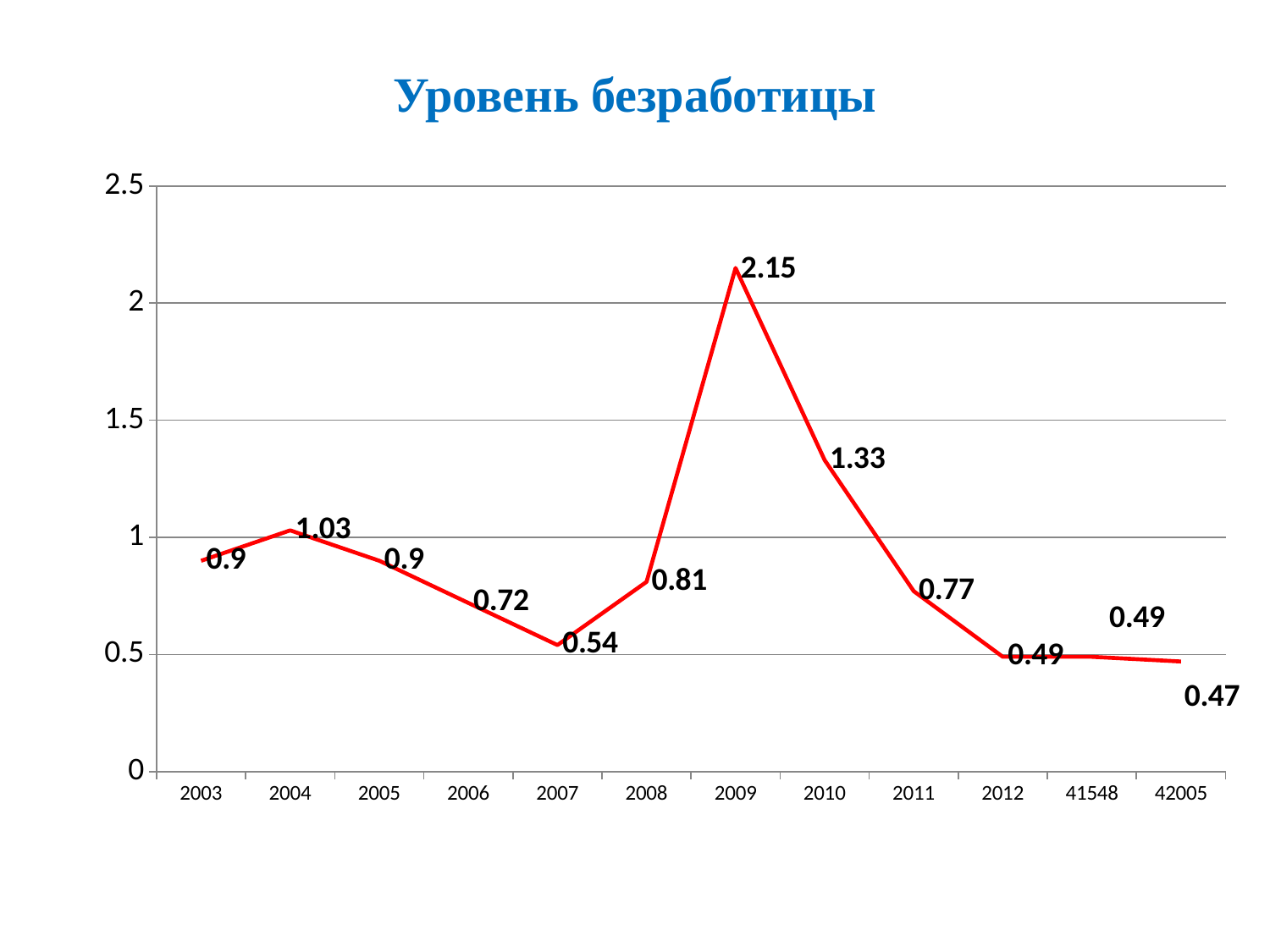
What type of chart is shown on the slide? line chart How many data points are plotted on the line? 12 Does the value rise or fall from 2004 to 2007? fall Which category has the lowest value? 42005 What is the value for 2007? 0.54 What is the title of the chart? Уровень безработицы What is the value for 2010? 1.33 What is the difference between the values for 2009 and 2010? 0.82 What is the value for 2009? 2.15 What is the value for the last point, labelled 42005? 0.47 Which is larger, the value for 2004 or the value for 2008? 2004 Which year has the highest value? 2009